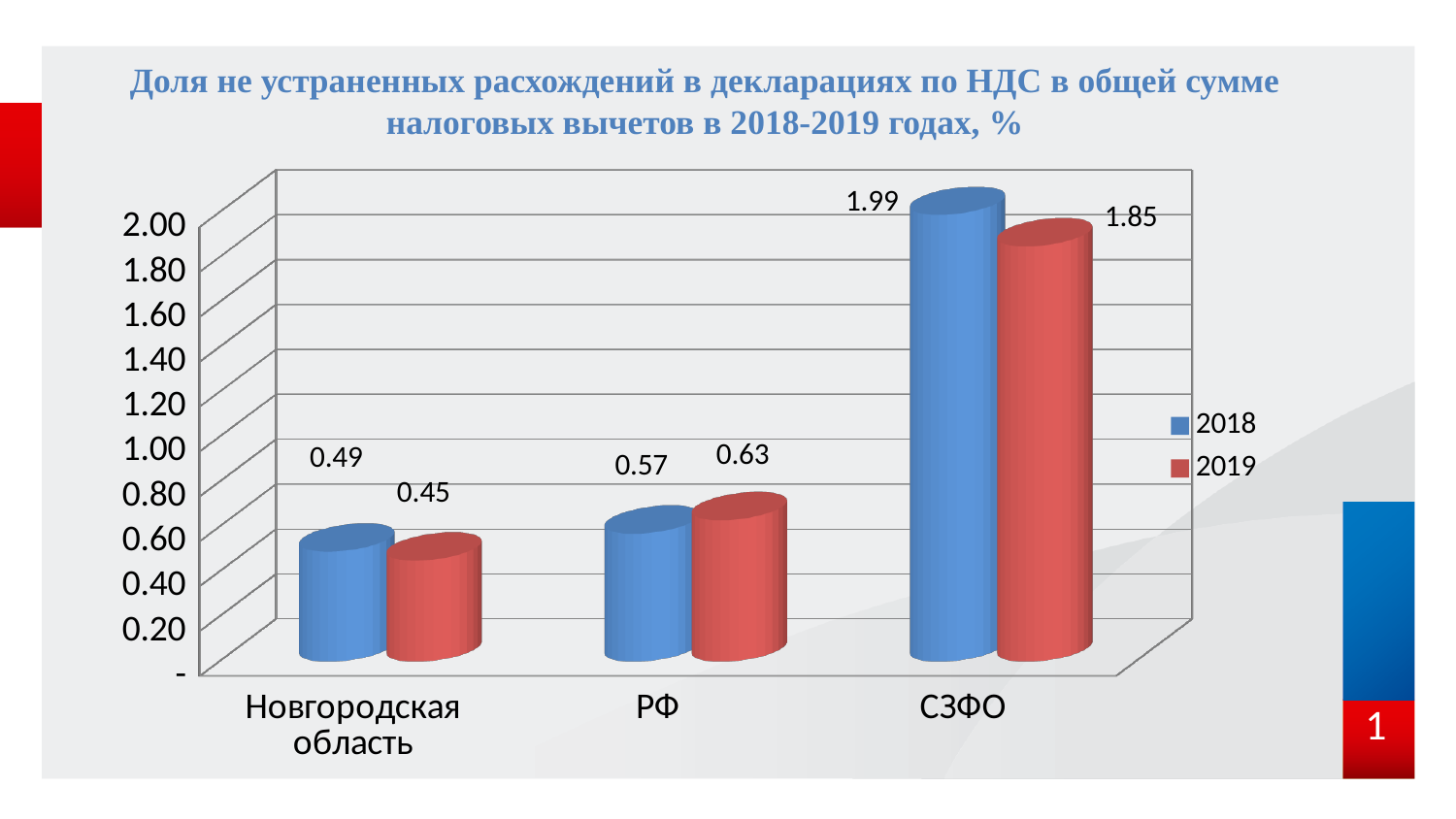
What kind of chart is shown on the slide? Bar chart Which colour represents the 2019 series in the legend? Red Which is larger for РФ: the 2018 value or the 2019 value? 2019 How many series does the legend list? 2 Which category has the lowest value in 2018? Новгородская область Which category has the highest value in 2019? СЗФО What is the value for Новгородская область in 2018? 0.49 How many categories are shown on the x axis? 3 What is the difference between the 2018 and 2019 values for СЗФО? 0.14 What is the value for Новгородская область in 2019? 0.45 What is the value for СЗФО in 2018? 1.99 What is the value for РФ in 2019? 0.63